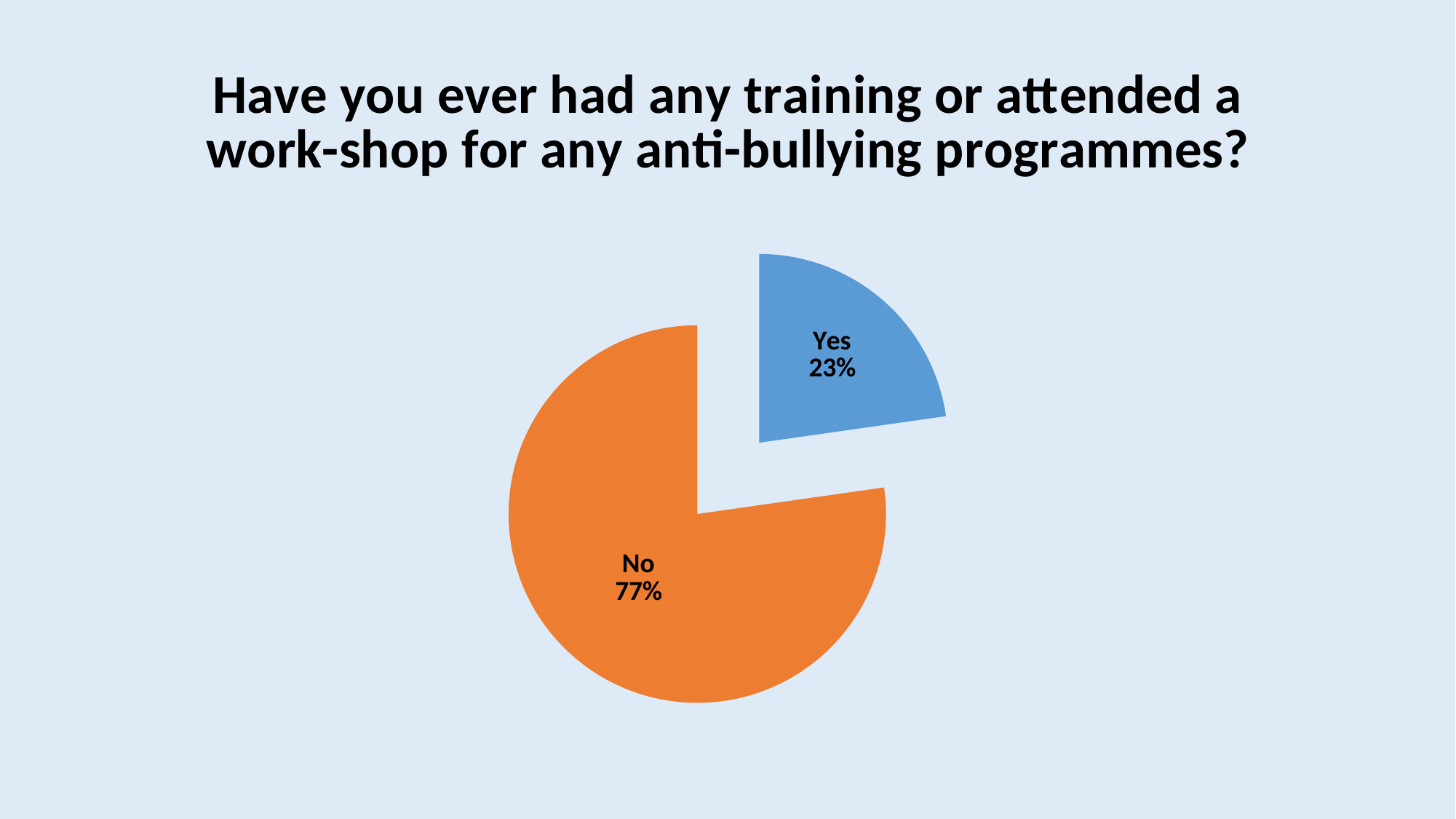
Which response has the smallest share of the pie? Yes How many slices does the pie chart have? 2 What kind of chart is shown on the slide? Pie chart What share of the pie does the Yes slice represent? 23% Which response has the largest share of the pie? No What percentage of respondents answered No? 77% What is the difference in percentage points between the No and Yes slices? 54 What colour is the No slice? Orange What colour is the Yes slice? Blue What percentage of respondents answered Yes? 23% Which slice is larger, Yes or No? No